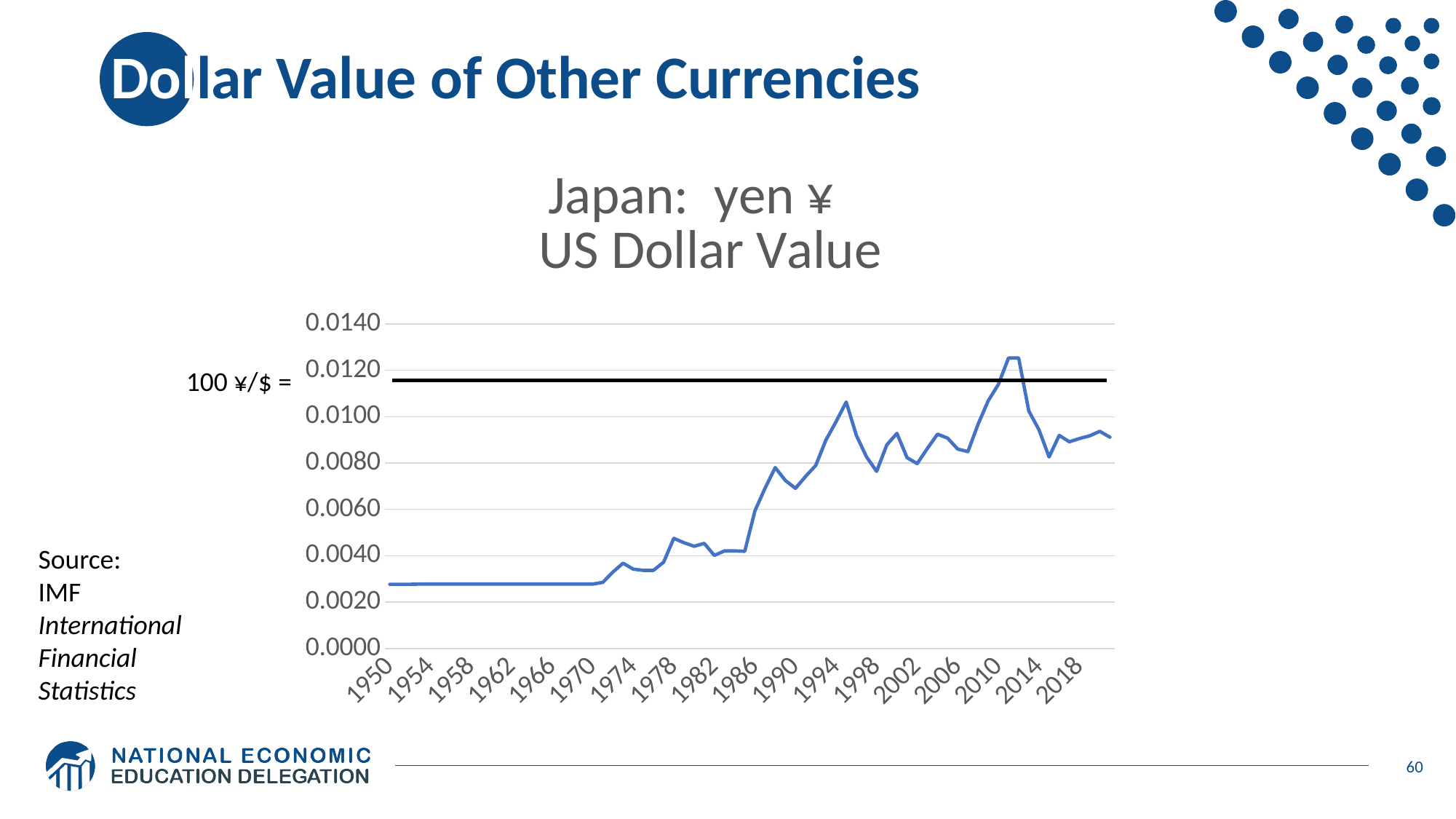
Overall, does the US dollar value of the yen rise or fall from 1950 to 2018? rise How many year labels are shown on the x axis? 18 What kind of chart is shown on the slide? line chart Is the value for 2018 greater or less than 0.0080? greater Is the value for 1990 greater or less than 0.0060? greater Is the value for 2010 greater or less than 0.0100? greater What does the horizontal black reference line on the chart represent? 100 ¥/$ What is the title of the chart? Japan: yen ¥ US Dollar Value Which is larger, the value for 1950 or the value for 2018? 2018